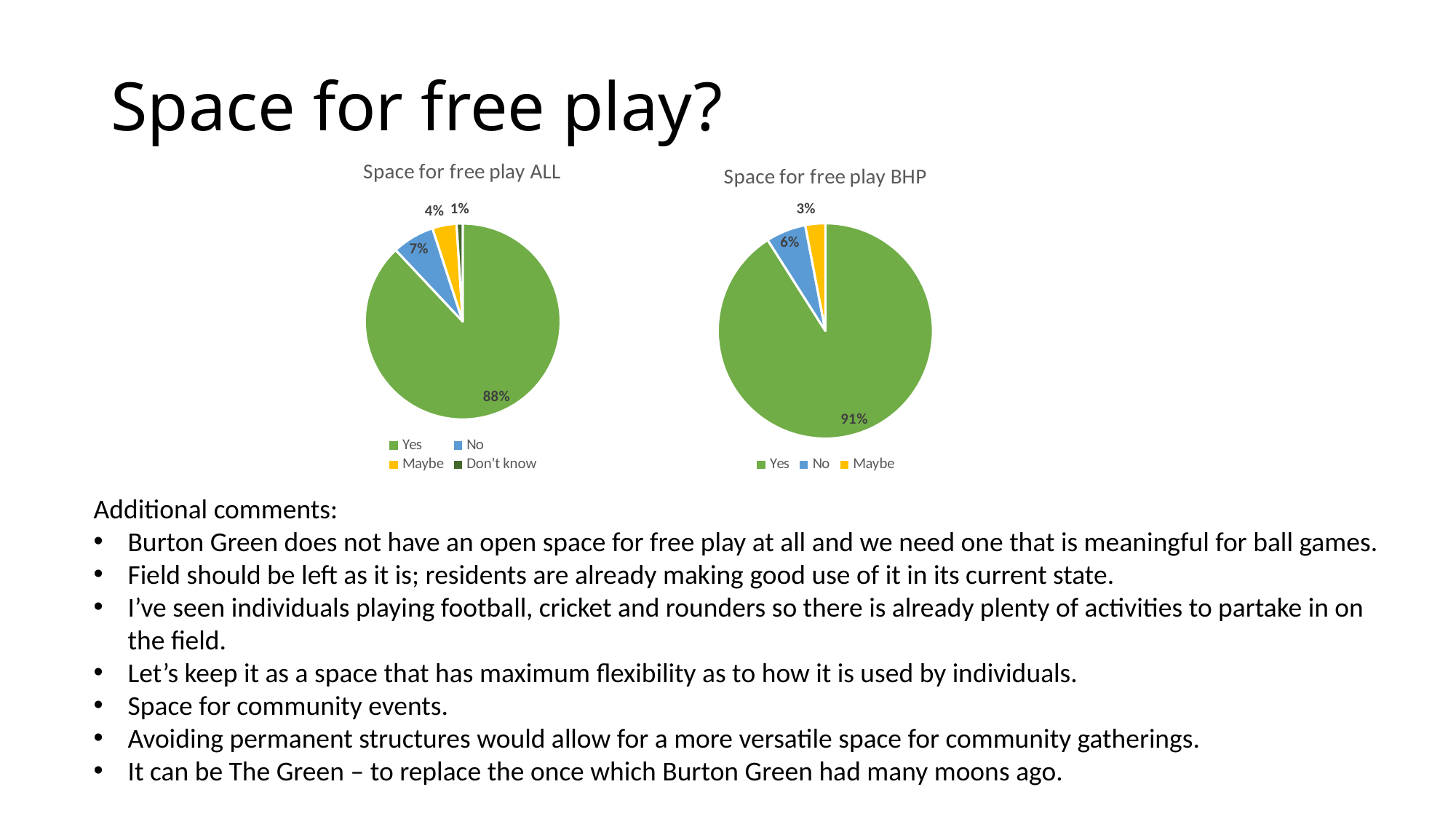
How many categories does the legend of the 'Space for free play BHP' chart list? 3 In the 'Space for free play ALL' chart, which is larger: the No share or the Maybe share? No In the 'Space for free play ALL' chart, what percentage answered Yes? 88% What type of chart is 'Space for free play BHP'? Pie chart What is the difference between the Yes share in the 'Space for free play BHP' chart and the Yes share in the 'Space for free play ALL' chart? 3% In the 'Space for free play BHP' chart, which response has the largest share? Yes In the 'Space for free play BHP' chart, what percentage answered Maybe? 3% In the 'Space for free play ALL' chart, what percentage answered Don't know? 1% In the 'Space for free play ALL' chart, what percentage answered No? 7% In the 'Space for free play ALL' chart, which response has the smallest share? Don't know How many categories does the legend of the 'Space for free play ALL' chart list? 4 In the 'Space for free play BHP' chart, what percentage answered Yes? 91%